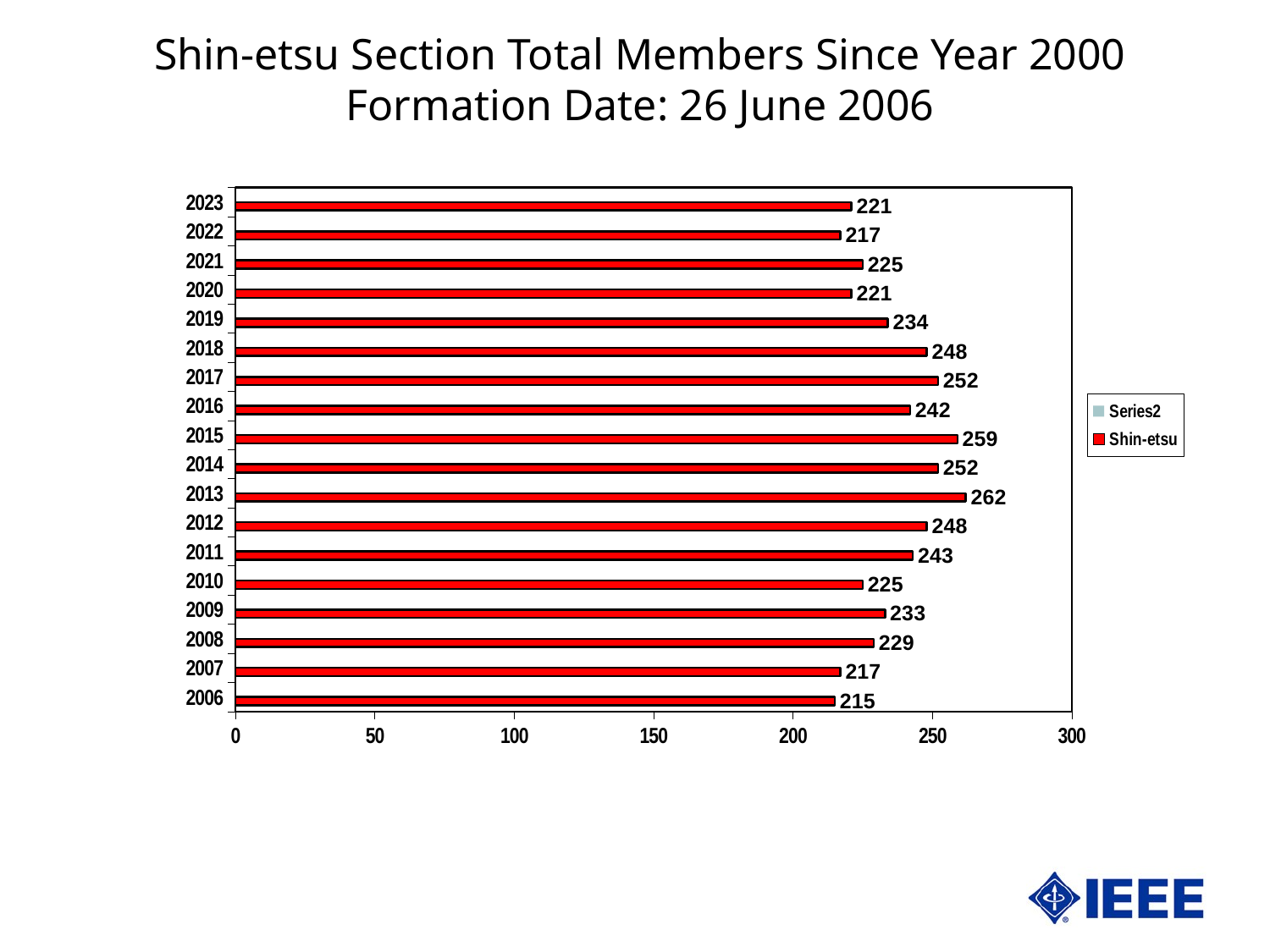
How many years are shown on the chart? 18 How many series does the legend list? 2 Is the Shin-etsu member count for 2017 greater or less than 250? greater What is the Shin-etsu member count for 2006? 215 Which year has the lowest Shin-etsu member count? 2006 What is the Shin-etsu member count for 2013? 262 What is the difference between the Shin-etsu member counts for 2015 and 2016? 17 What colour are the Shin-etsu bars? red Which year has a larger Shin-etsu member count, 2019 or 2018? 2018 What is the Shin-etsu member count for 2023? 221 Which year has the highest Shin-etsu member count? 2013 What kind of chart is shown on the slide? bar chart